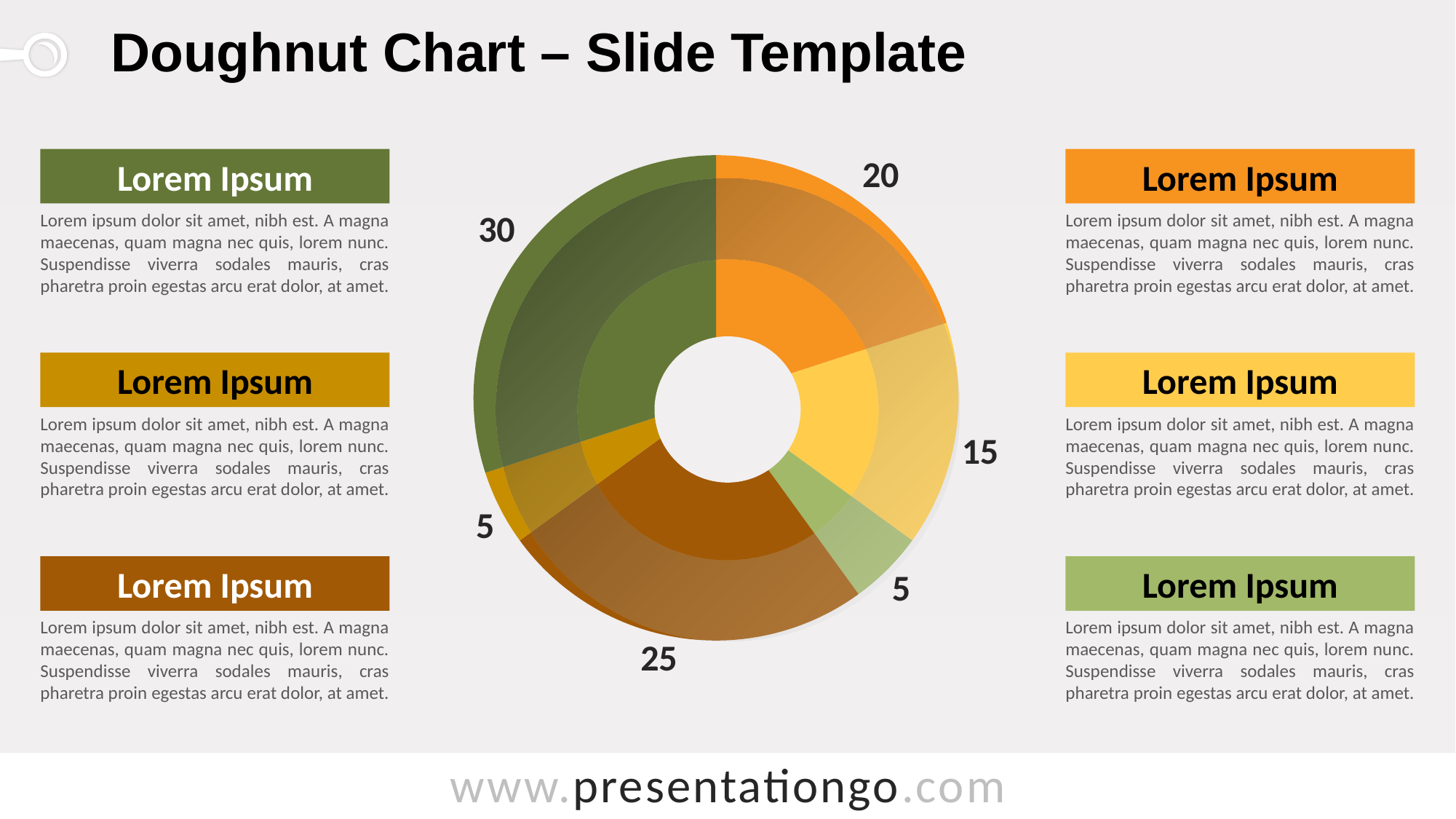
What is the value of the orange slice at the top right of the doughnut chart? 20 What is the value of the dark green slice on the upper left of the doughnut chart? 30 What is the difference between the largest slice (30) and the brown slice (25)? 5 What is the largest value shown on the doughnut chart? 30 What is the value of the yellow slice on the right side of the doughnut chart? 15 What is the total of all the slice values in the doughnut chart? 100 What is the value of the brown slice at the bottom of the doughnut chart? 25 How many slices does the doughnut chart have? 6 What share of the total does the dark green slice (30) represent? 30% What is the smallest value shown on the doughnut chart? 5 Which is larger, the orange slice or the yellow slice? The orange slice (20) What kind of chart is shown on the slide? Doughnut chart